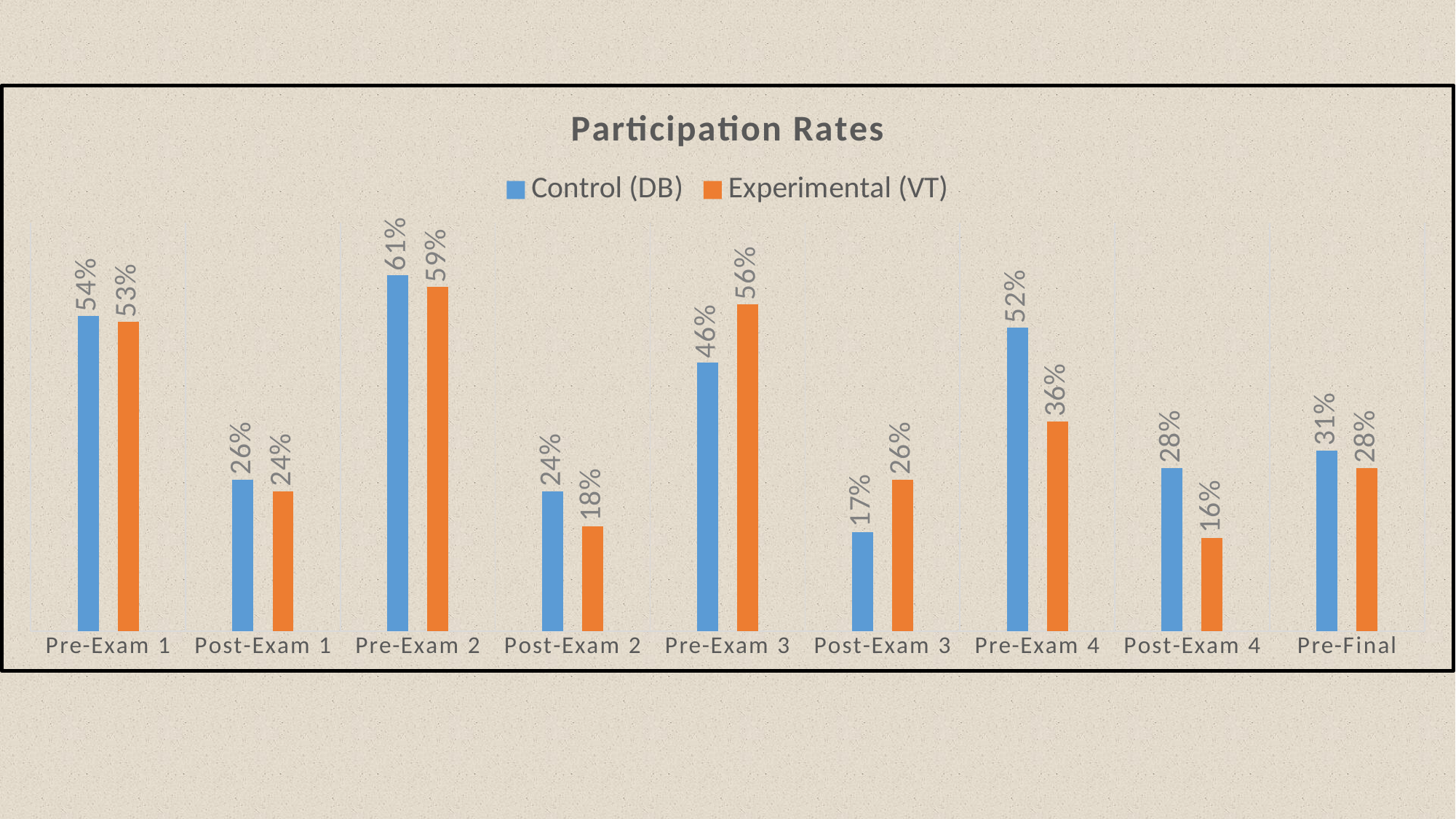
What kind of chart is shown? Bar chart What is the difference between the Control (DB) and Experimental (VT) rates for Pre-Exam 4? 16% How many series does the legend list? 2 Which series has the larger value for Post-Exam 3, Control (DB) or Experimental (VT)? Experimental (VT) Which colour represents the Experimental (VT) series? Orange What is the Control (DB) participation rate for Pre-Exam 2? 61% Which category has the highest Control (DB) participation rate? Pre-Exam 2 What is the Experimental (VT) participation rate for Post-Exam 4? 16% How many categories are shown on the x axis? 9 What is the title of the chart? Participation Rates Which category has the lowest Experimental (VT) participation rate? Post-Exam 4 What is the Experimental (VT) participation rate for Pre-Exam 3? 56%